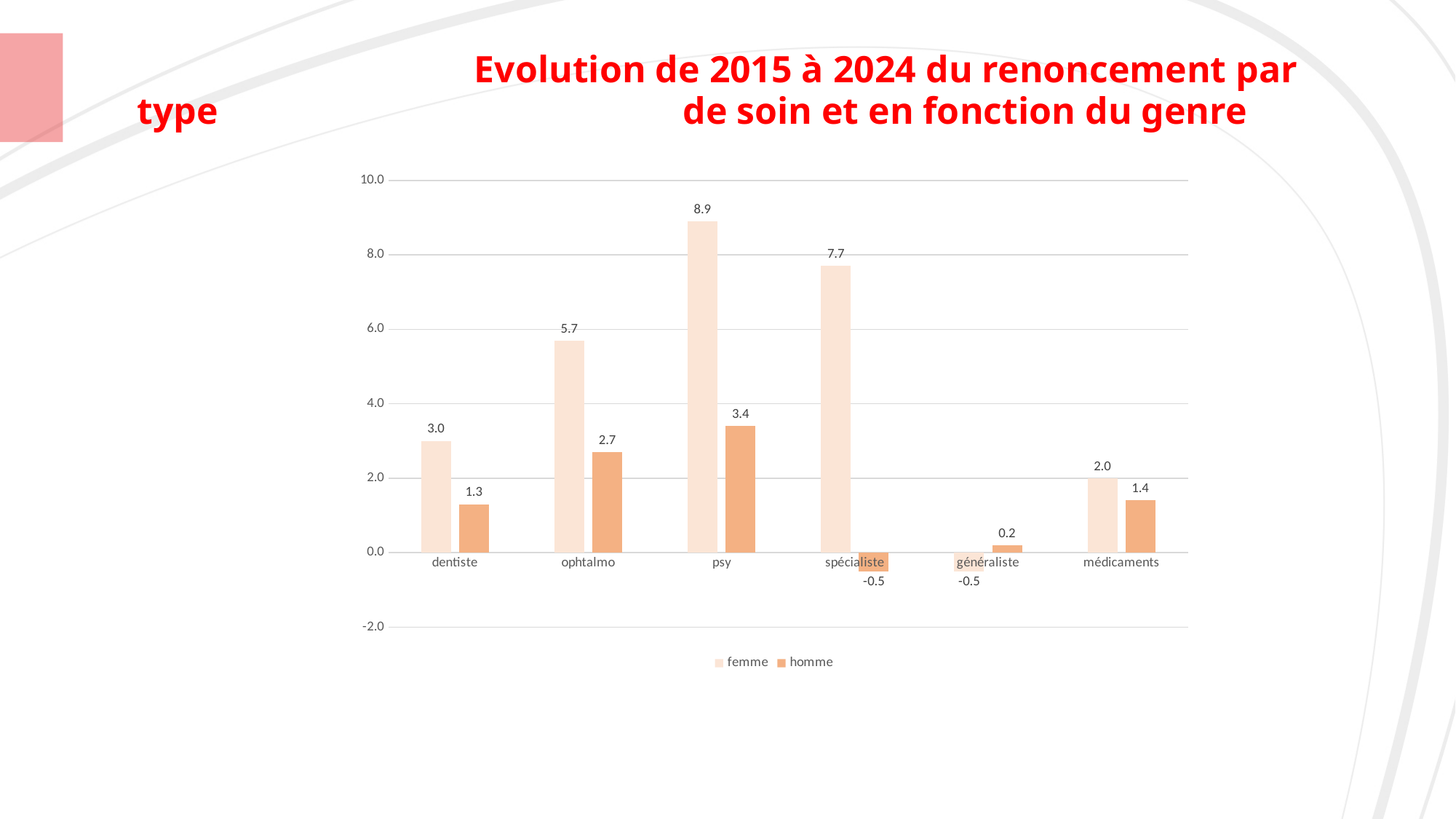
What is the value for femme in the médicaments category? 2.0 What is the value for femme in the psy category? 8.9 What is the value for homme in the spécialiste category? -0.5 How many series does the legend list? 2 What is the value for homme in the ophtalmo category? 2.7 Which category has the highest value for femme? psy What kind of chart is shown on the slide? bar chart How many categories are shown on the x axis? 6 What is the difference between the femme and homme values for psy? 5.5 What are the two series named in the legend? femme and homme Which is larger, the femme value for dentiste or the homme value for psy? homme value for psy Which category has the lowest value for homme? spécialiste